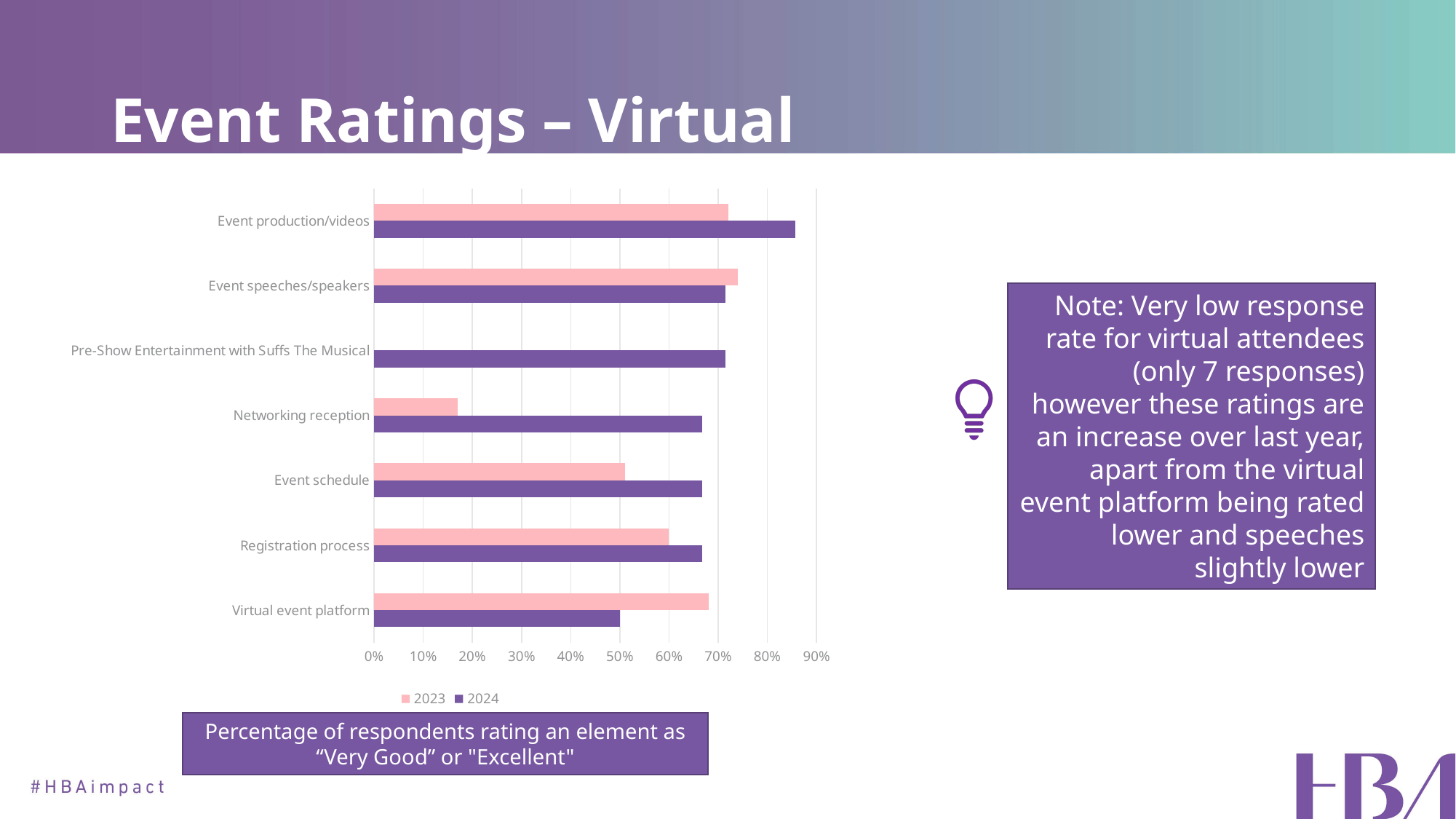
How many categories are plotted on the chart? 7 For Virtual event platform, which year has the larger value, 2023 or 2024? 2023 Is the 2024 value for Virtual event platform greater or less than 60%? less Is the 2024 value for Event production/videos greater or less than 80%? greater Is the 2023 value for Networking reception greater or less than 20%? less For Networking reception, which year has the larger value, 2023 or 2024? 2024 What kind of chart is shown on the slide? Bar chart Which category has no 2023 bar shown on the chart? Pre-Show Entertainment with Suffs The Musical Which category has the highest 2024 value? Event production/videos Which category has the lowest 2023 value among those with a 2023 bar? Networking reception Which category has the lowest 2024 value? Virtual event platform How many series does the chart's legend list? 2